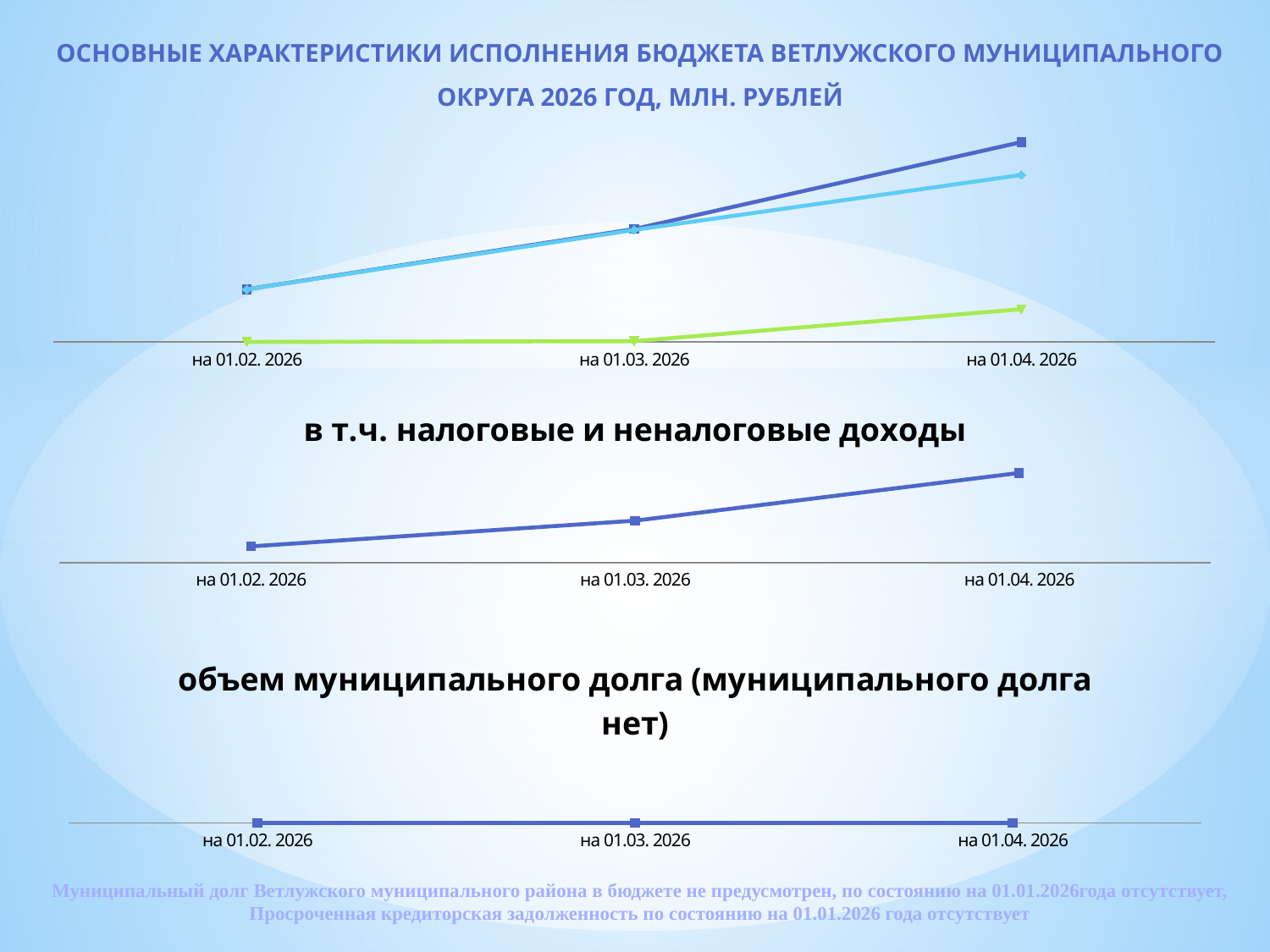
How many dates are shown on the x axis of the top chart? 3 In the chart 'объем муниципального долга (муниципального долга нет)', do the values rise, fall or stay flat across the dates? stay flat What kind of chart is the top chart on the slide? line chart How many data points are plotted in the chart 'объем муниципального долга (муниципального долга нет)'? 3 In the chart 'в т.ч. налоговые и неналоговые доходы', on which date is the value lowest? на 01.02. 2026 In the top chart, does the green line rise or fall from на 01.02. 2026 to на 01.04. 2026? rise What is the title of the middle chart? в т.ч. налоговые и неналоговые доходы In the top chart, on which date does the dark blue line reach its highest value? на 01.04. 2026 In the chart 'в т.ч. налоговые и неналоговые доходы', which is larger: the value for на 01.04. 2026 or the value for на 01.02. 2026? на 01.04. 2026 In the chart 'в т.ч. налоговые и неналоговые доходы', do the values rise or fall from на 01.02. 2026 to на 01.04. 2026? rise In the top chart, which line is highest at на 01.04. 2026? the dark blue line How many lines are plotted in the top chart? 3